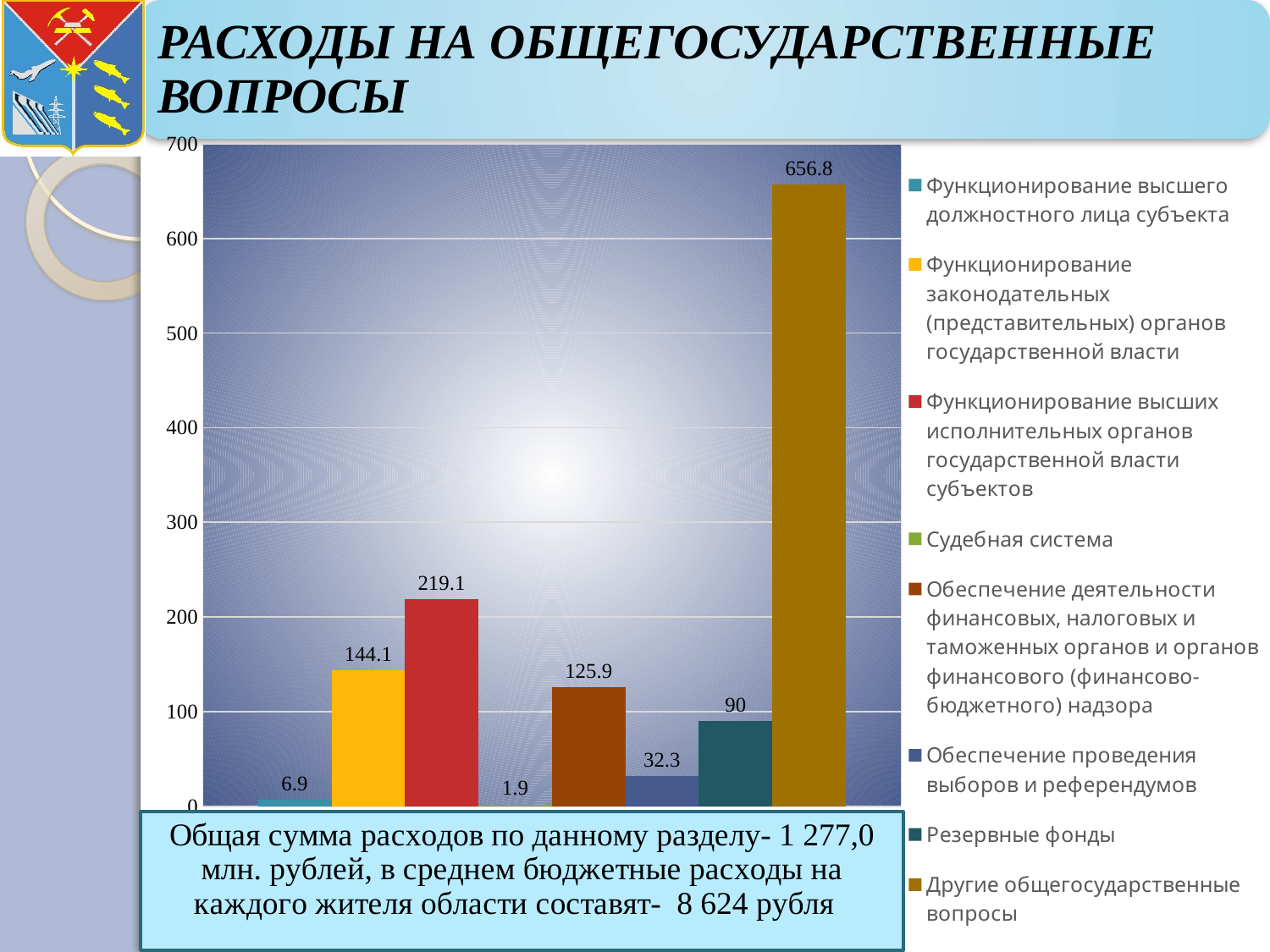
What is the value for Судебная система? 1.9 What is the title of the slide containing the chart? РАСХОДЫ НА ОБЩЕГОСУДАРСТВЕННЫЕ ВОПРОСЫ Is the value for Функционирование высших исполнительных органов государственной власти субъектов greater or less than 200? greater Which legend entry has the highest value? Другие общегосударственные вопросы Which is larger: the value for Резервные фонды or the value for Обеспечение проведения выборов и референдумов? Резервные фонды What is the value for Резервные фонды? 90 What is the value for Функционирование высших исполнительных органов государственной власти субъектов? 219.1 How many series does the legend list? 8 What is the value for Другие общегосударственные вопросы? 656.8 What is the difference between the values for Функционирование законодательных (представительных) органов государственной власти and Обеспечение деятельности финансовых, налоговых и таможенных органов и органов финансового (финансово-бюджетного) надзора? 18.2 What kind of chart is shown on the slide? bar chart Which legend entry has the lowest value? Судебная система